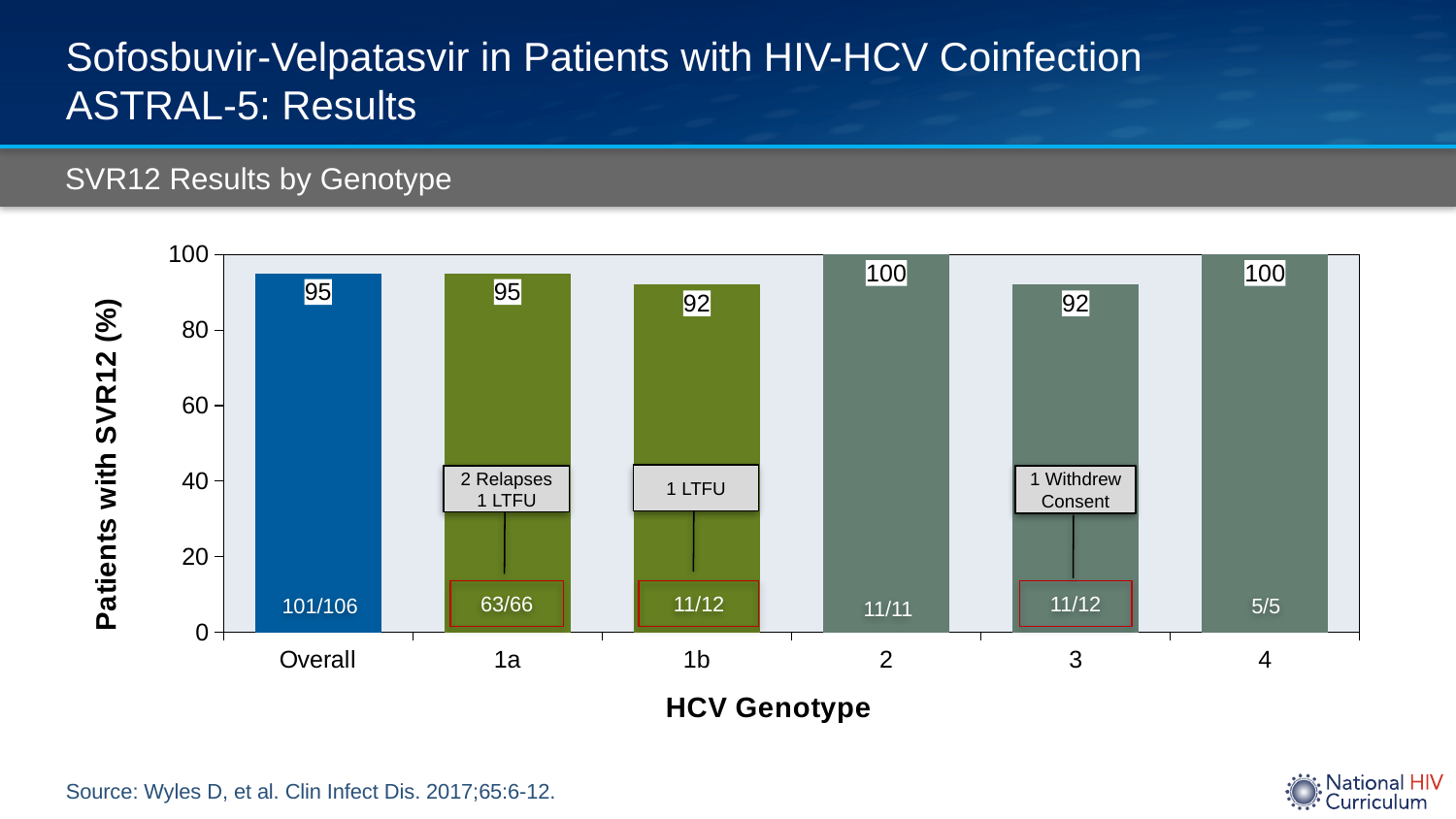
What annotation is shown on the genotype 3 bar? 1 Withdrew Consent Which has a higher SVR12 rate, genotype 1a or genotype 3? Genotype 1a What is the SVR12 rate for genotype 1b? 92 Which genotypes have the highest SVR12 rate? 2 and 4 What fraction of patients achieved SVR12 in genotype 4? 5/5 How many categories are shown on the x axis? 6 What is the SVR12 rate for the Overall group? 95 What is the label of the y axis? Patients with SVR12 (%) What kind of chart is shown? Bar chart What is the difference in SVR12 rate between genotype 2 and genotype 1b? 8 What is the SVR12 rate for genotype 3? 92 What fraction of patients achieved SVR12 in genotype 1a? 63/66